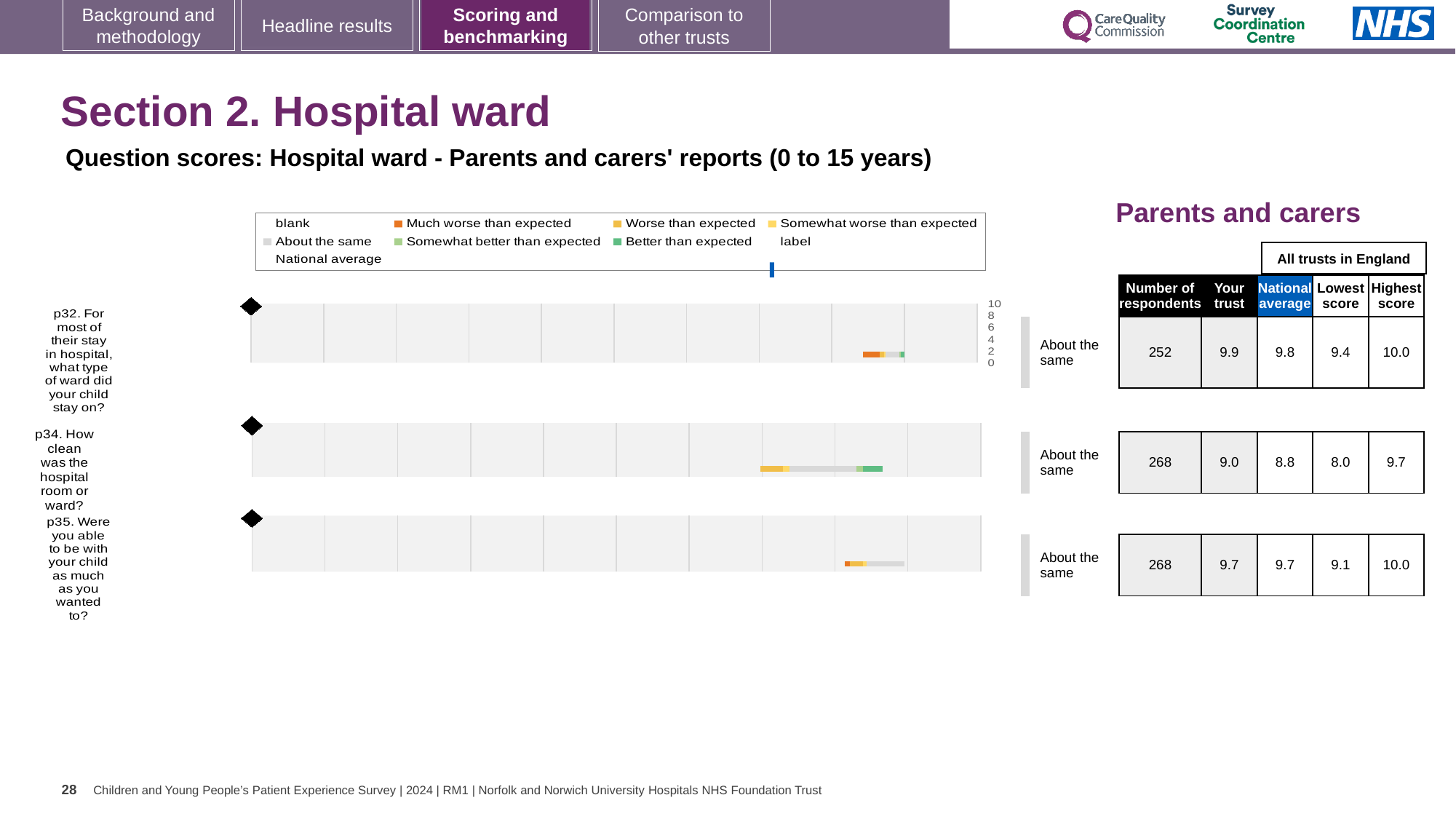
What benchmark category is shown next to the chart for p35? About the same How many questions (p32, p34, p35) have a chart on this slide? 3 Which question has the highest 'Your trust' score? p32 What is the 'Your trust' score for p34 (how clean was the hospital room or ward)? 9.0 What is the number of respondents for p32 (what type of ward did your child stay on)? 252 Which question has the lowest 'Your trust' score? p34 For p34, which is larger: the 'Your trust' score or the national average? Your trust What kind of chart is used to show the question scores on this slide? bar chart What is the lowest score among all trusts in England for p34? 8.0 What is the national average for p35 (were you able to be with your child as much as you wanted to)? 9.7 What is the difference between the highest score and the lowest score for p32? 0.6 What is the highest score among all trusts in England for p32? 10.0